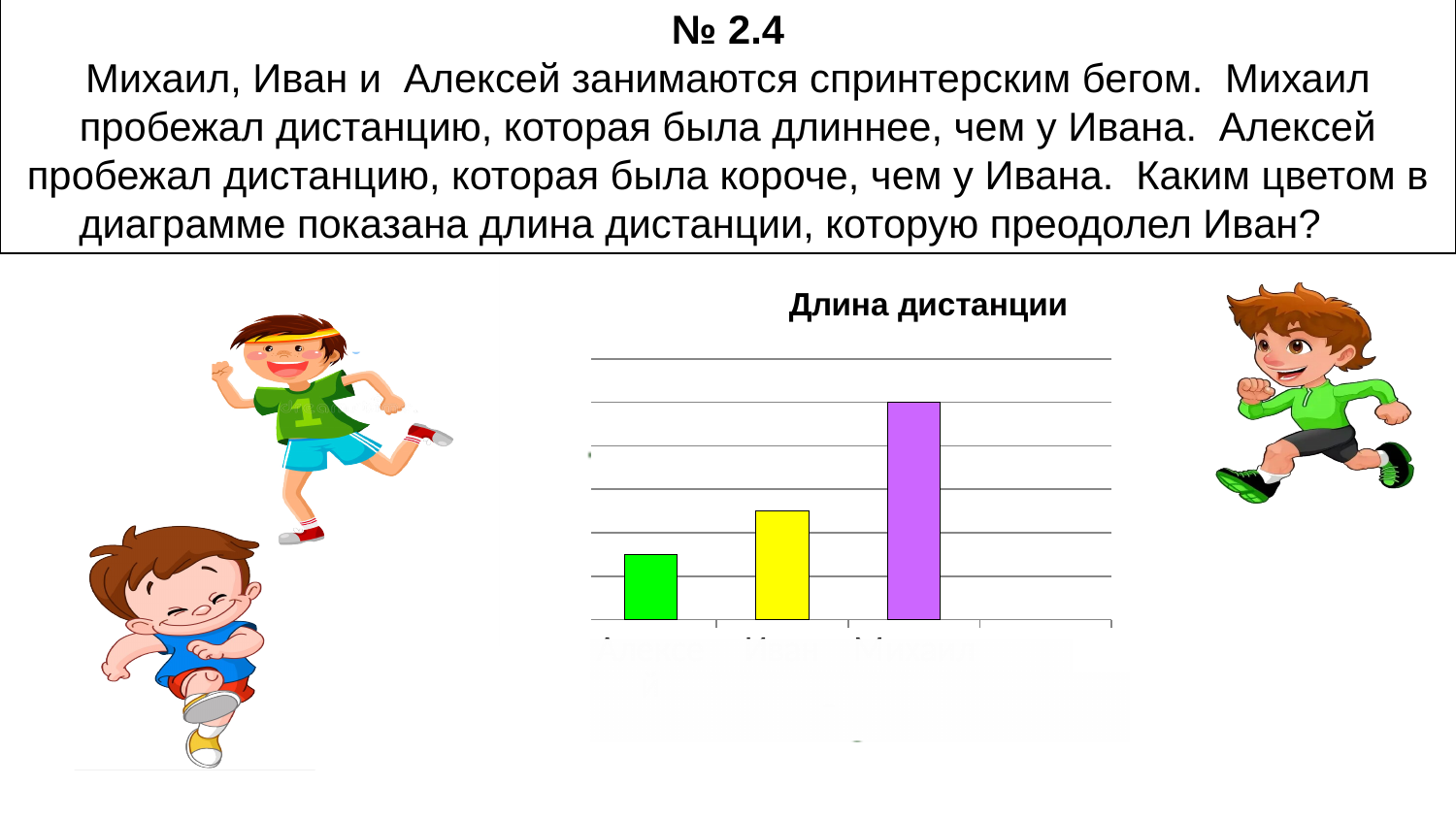
Which colour bar is the tallest in the chart? purple What is the title of the chart? Длина дистанции What colour is the middle bar in the chart? yellow Do the bar heights rise or fall from left to right across the chart? rise How many bars does the chart show? 3 What kind of chart is shown on the slide? bar chart Which bar is taller, the yellow bar or the green bar? yellow Which colour bar is the shortest in the chart? green Which bar is taller, the purple bar or the yellow bar? purple